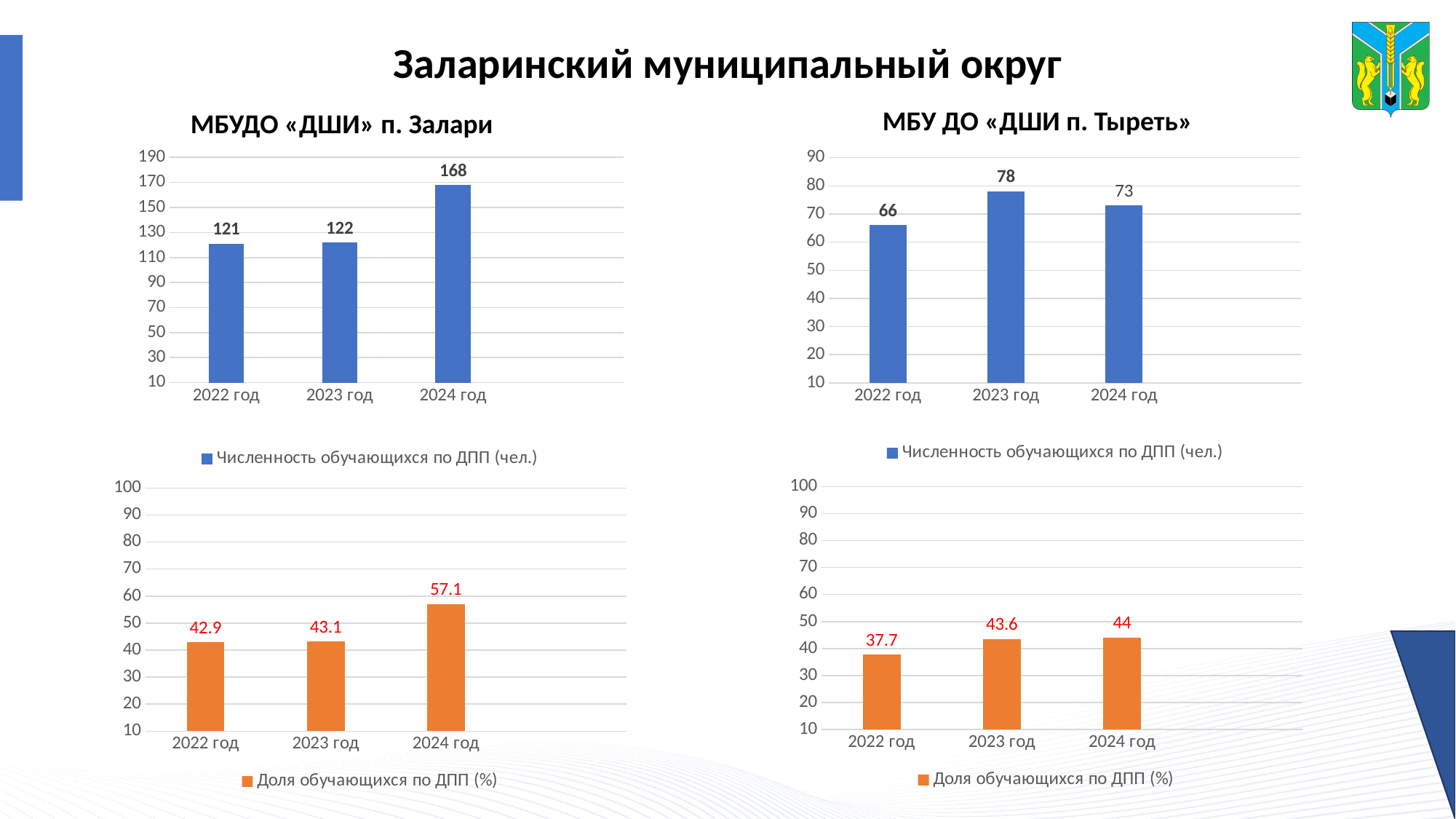
What is the legend entry of the bottom-left chart? Доля обучающихся по ДПП (%) How many bars are plotted in the bottom-left chart (Доля обучающихся по ДПП (%) for п. Залари)? 3 In the top-left chart (МБУДО «ДШИ» п. Залари, численность обучающихся по ДПП), what is the value for 2024 год? 168 In the bottom-right chart (Доля обучающихся по ДПП (%) for п. Тыреть), which year has the lowest value? 2022 год In the top-right chart (МБУ ДО «ДШИ п. Тыреть», численность обучающихся по ДПП), what is the value for 2023 год? 78 In the bottom-right chart (Доля обучающихся по ДПП (%) for п. Тыреть), do the values rise or fall from 2022 год to 2024 год? Rise In the bottom-right chart (Доля обучающихся по ДПП (%) for п. Тыреть), what is the value for 2024 год? 44 What type of chart is the top-left chart (МБУДО «ДШИ» п. Залари)? Bar chart In the top-right chart (МБУ ДО «ДШИ п. Тыреть», численность), which year has the highest value? 2023 год In the bottom-left chart (Доля обучающихся по ДПП (%) for п. Залари), what is the value for 2022 год? 42.9 In the top-left chart (МБУДО «ДШИ» п. Залари, численность), what is the difference between the values for 2024 год and 2023 год? 46 In the top-right chart (МБУ ДО «ДШИ п. Тыреть», численность), which is larger: the value for 2022 год or 2024 год? 2024 год